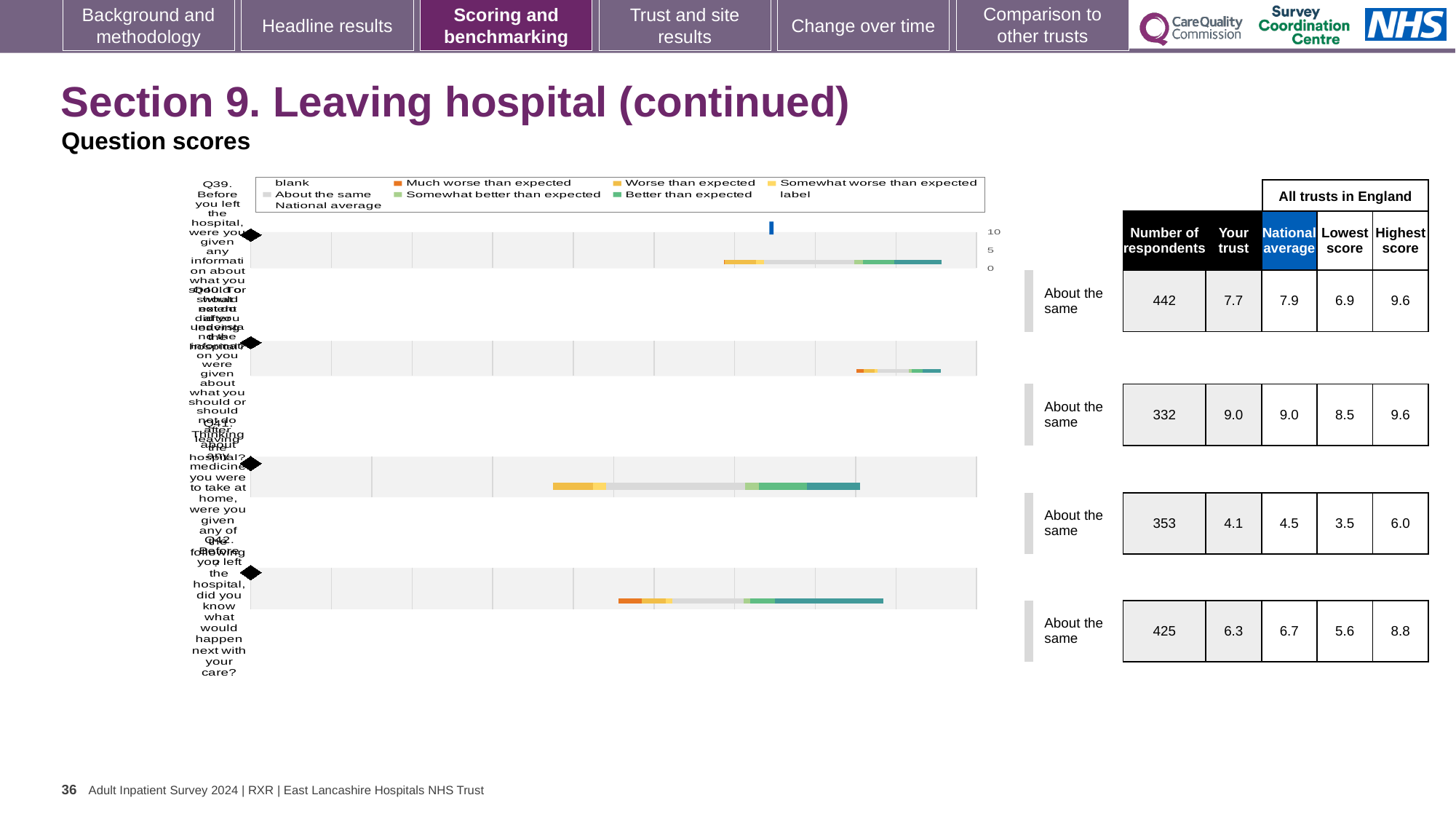
What is the lowest score for Q39 in the table beside the chart? 6.9 In the table beside the chart, what is the 'Your trust' score for Q39? 7.7 In the table beside the chart, what is the national average for Q41? 4.5 What is the difference between the highest score and the lowest score for Q42 in the table? 3.2 What is the benchmark category shown next to each of the four question bars? About the same Which question has the lowest 'Your trust' score in the table beside the chart? Q41 In the table beside the chart, how many respondents answered Q40? 332 In the table beside the chart, what is the highest score for Q42? 8.8 For Q41, which is larger: the 'Your trust' score or the national average? National average Which question has the highest 'Your trust' score in the table beside the chart? Q40 How many question bars (Q39 to Q42) are plotted in the chart? 4 What kind of chart is shown on the slide? bar chart